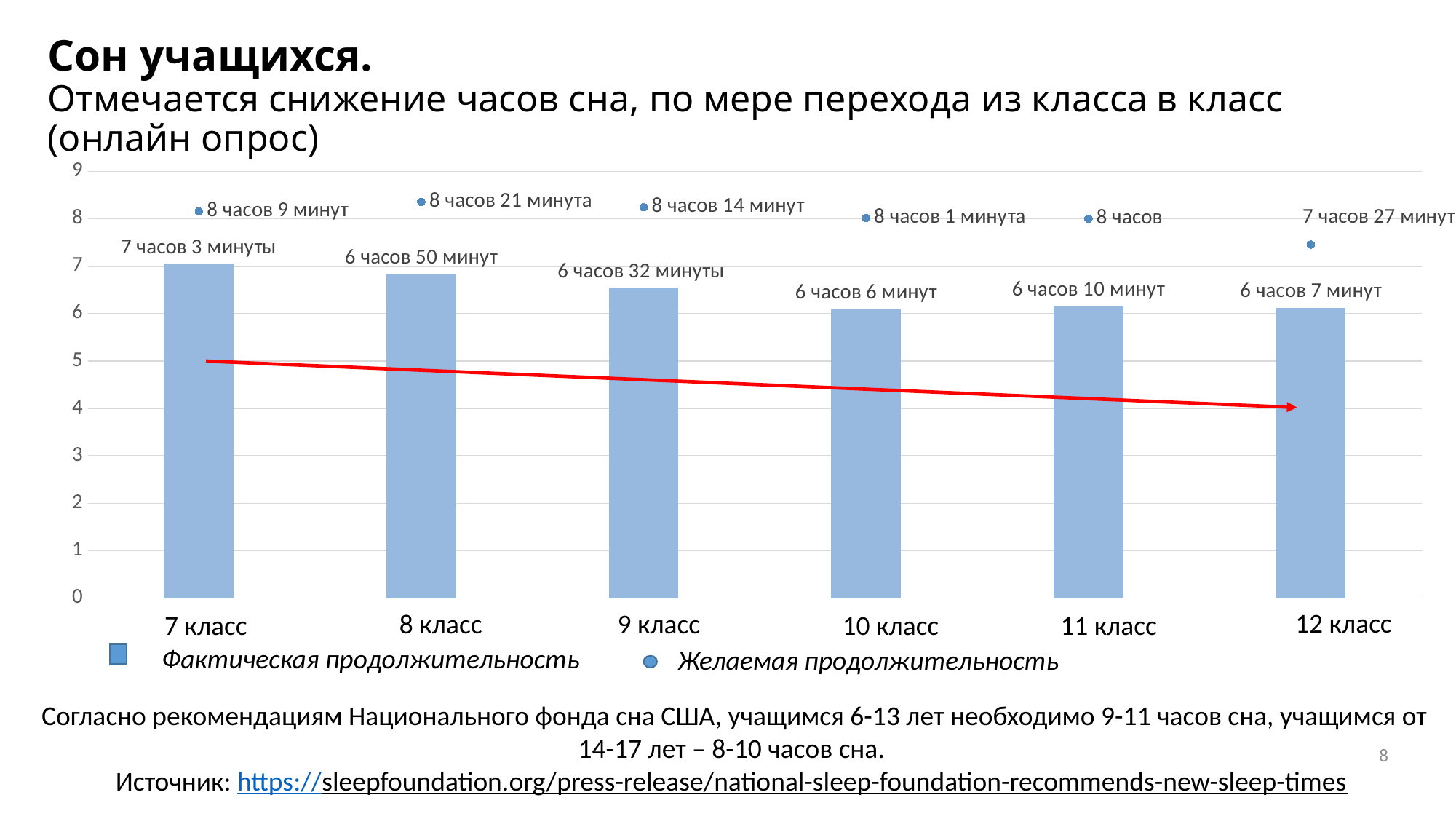
What is the actual sleep duration for 10 класс? 6 часов 6 минут What is the desired sleep duration (Желаемая продолжительность) for 8 класс? 8 часов 21 минута Which grade has the highest desired sleep duration? 8 класс What is the actual sleep duration (Фактическая продолжительность) for 7 класс? 7 часов 3 минуты Is the desired sleep duration for 12 класс greater or less than 8 hours? less How many series does the legend list? 2 Is the actual sleep duration for 11 класс larger or smaller than for 10 класс? larger Do the actual sleep duration values generally rise or fall from 7 класс to 12 класс? fall Which grade has the highest actual sleep duration? 7 класс How many grades (categories) are shown on the x axis? 6 Which grade has the lowest desired sleep duration? 12 класс What is the desired sleep duration for 12 класс? 7 часов 27 минут